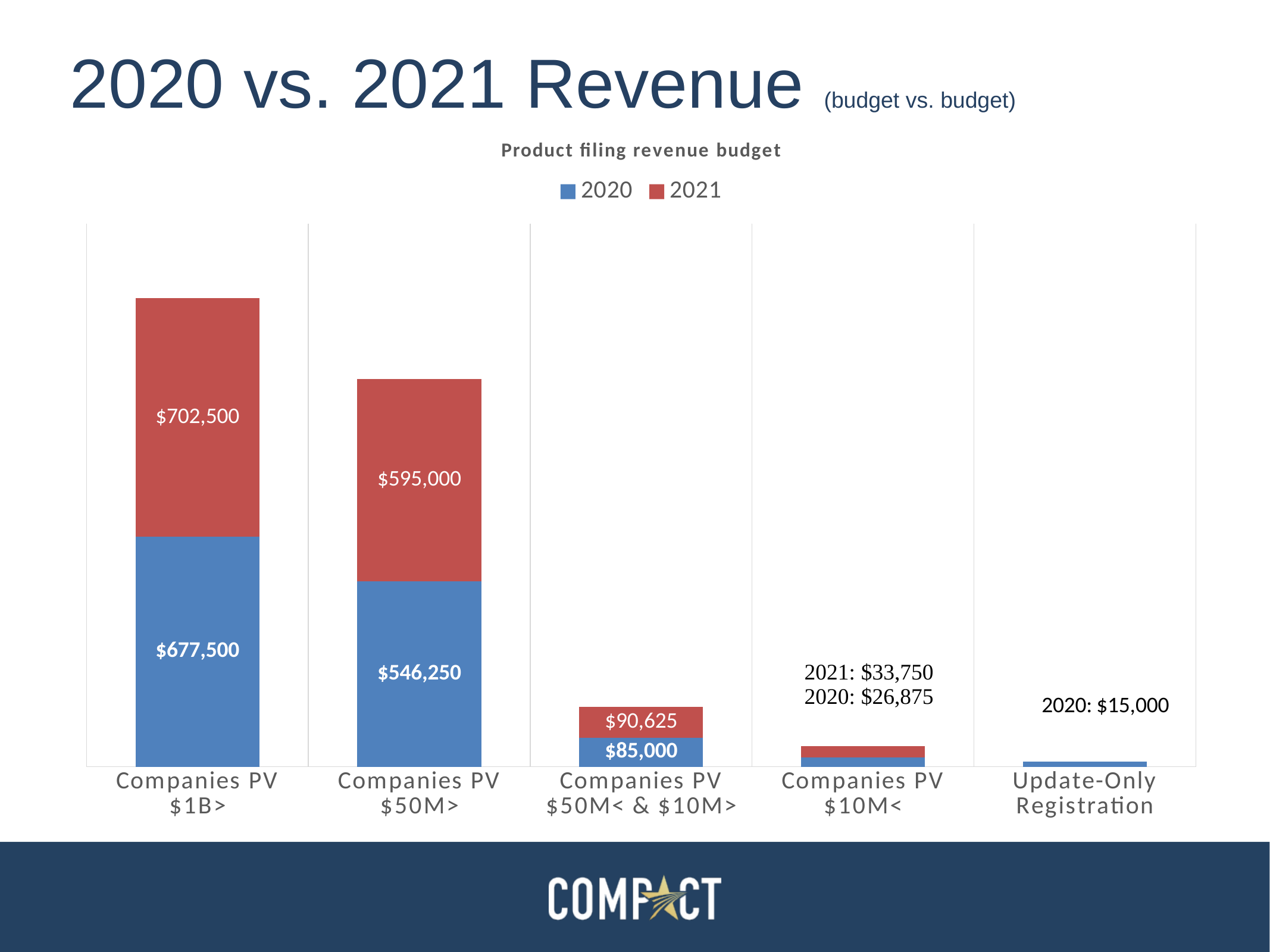
What is the 2021 value for Companies PV $50M< & $10M>? $90,625 What is the total of the stacked bar for Companies PV $1B>? $1,380,000 What is the 2021 value for Companies PV $50M>? $595,000 How many series does the legend list? 2 Which category has the lowest 2020 value? Update-Only Registration What is the 2020 value for Companies PV $1B>? $677,500 What is the 2020 value for Update-Only Registration? $15,000 How many categories are shown on the x axis? 5 Which category has the highest 2021 value? Companies PV $1B> What is the difference between the 2021 and 2020 values for Companies PV $50M>? $48,750 What is the 2020 value for Companies PV $10M<? $26,875 Which is larger for Companies PV $10M<: the 2020 value or the 2021 value? 2021